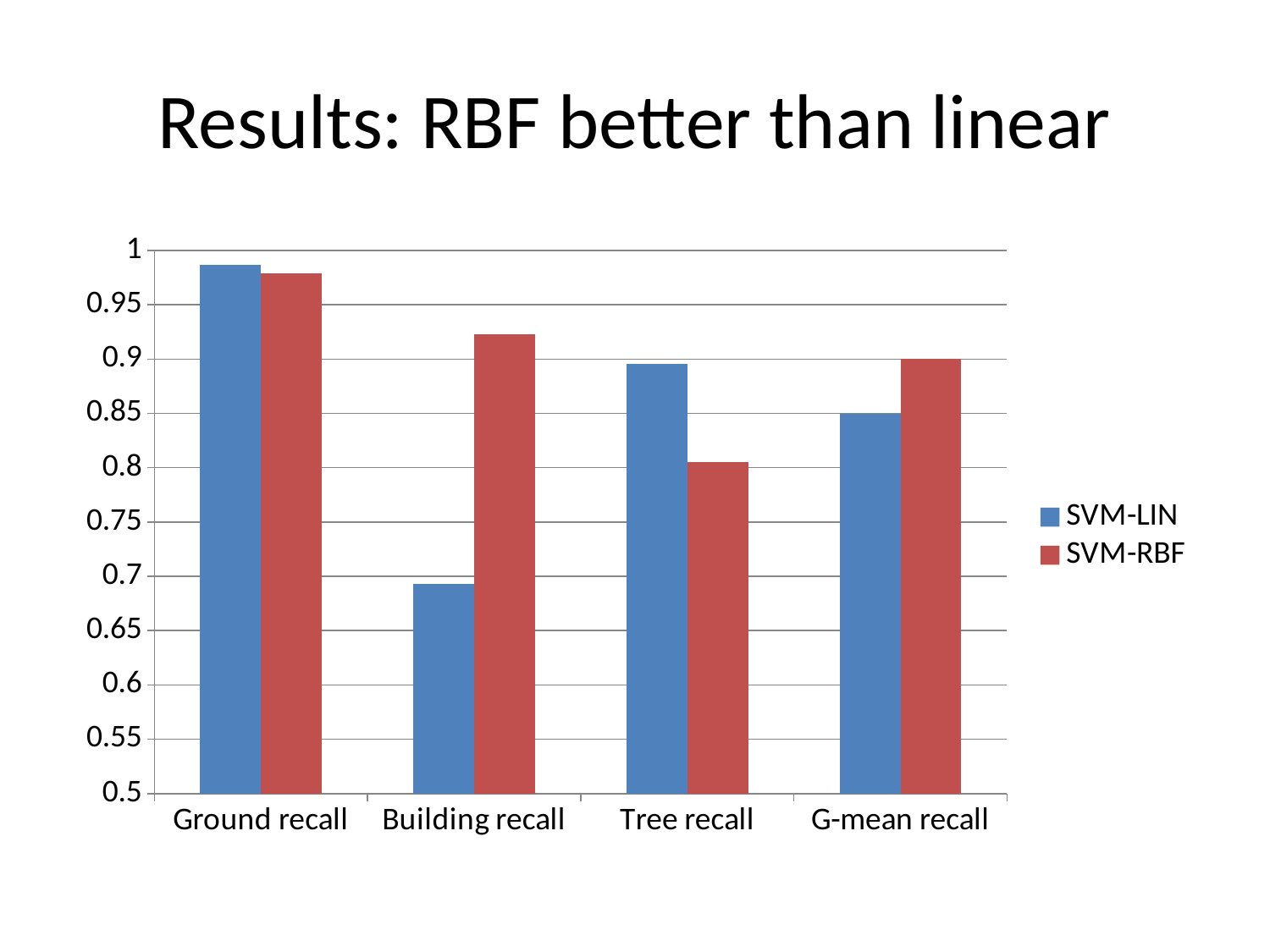
Which category has the lowest SVM-LIN value? Building recall Is the SVM-LIN value for Building recall greater or less than 0.7? less Is the SVM-RBF value for Tree recall greater or less than 0.85? less For Tree recall, which series has the larger value, SVM-LIN or SVM-RBF? SVM-LIN What kind of chart is shown on the slide? bar chart How many categories are shown on the x axis? 4 What is the title of the slide? Results: RBF better than linear For Building recall, which series has the larger value, SVM-LIN or SVM-RBF? SVM-RBF Which category has the highest SVM-RBF value? Ground recall Which category has the lowest SVM-RBF value? Tree recall How many series does the legend list? 2 Which category has the highest SVM-LIN value? Ground recall